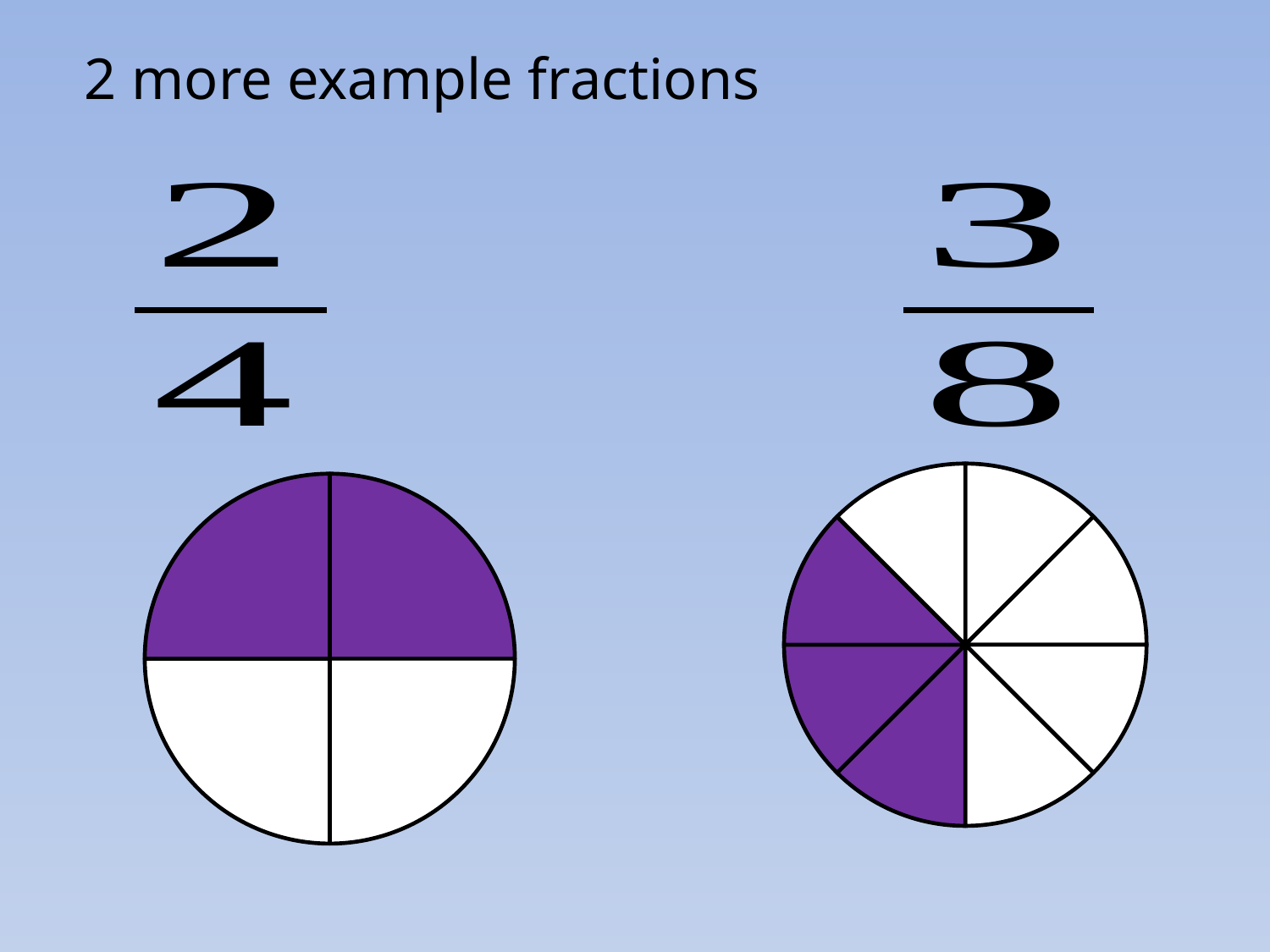
What kind of chart is the left diagram? pie chart What colour are the shaded parts in both circles? purple What is the title of the slide containing the two circle diagrams? 2 more example fractions How many equal parts is the right circle divided into? 8 In the left circle, how many parts are shaded purple? 2 What share of the left circle is shaded purple? 2/4 Which circle has more shaded parts, the left or the right? right In the right circle, how many parts are shaded purple? 3 What fraction is written above the left circle? 2/4 What fraction is written above the right circle? 3/8 What share of the right circle is shaded purple? 3/8